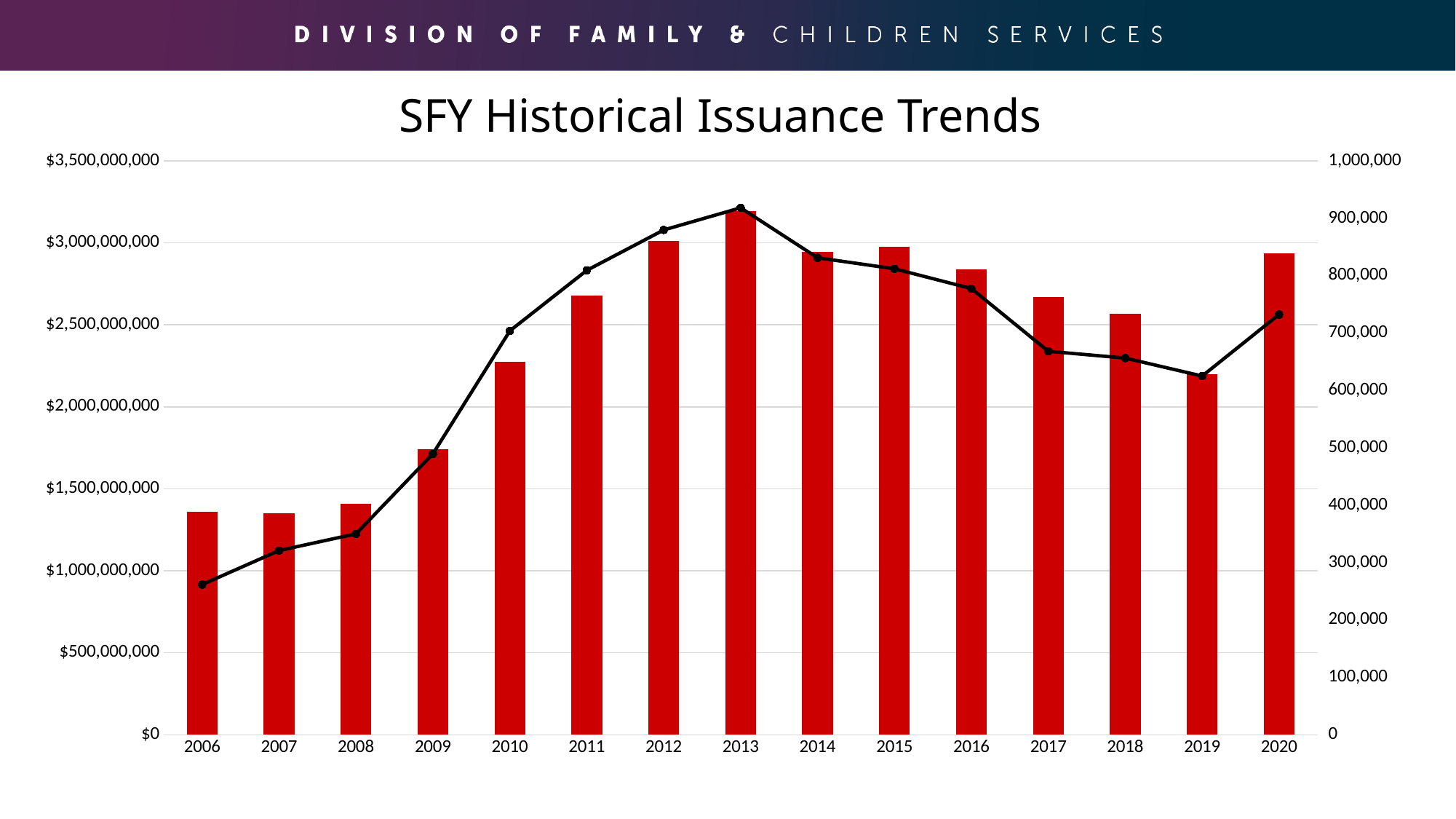
Is the line value for 2019 on the right axis greater or less than 600,000? greater What is the title of the chart? SFY Historical Issuance Trends Do the bar values rise or fall from 2013 to 2019? fall Is the bar value for 2010 greater or less than $2,500,000,000? less How many years are shown on the x axis of the chart? 15 Which year has the tallest bar in the chart? 2013 Is the bar value for 2006 greater or less than $1,500,000,000? less Which year has the taller bar, 2011 or 2012? 2012 What colour are the bars in the chart? Red What kind of chart is shown on the slide? A bar chart with a line overlay